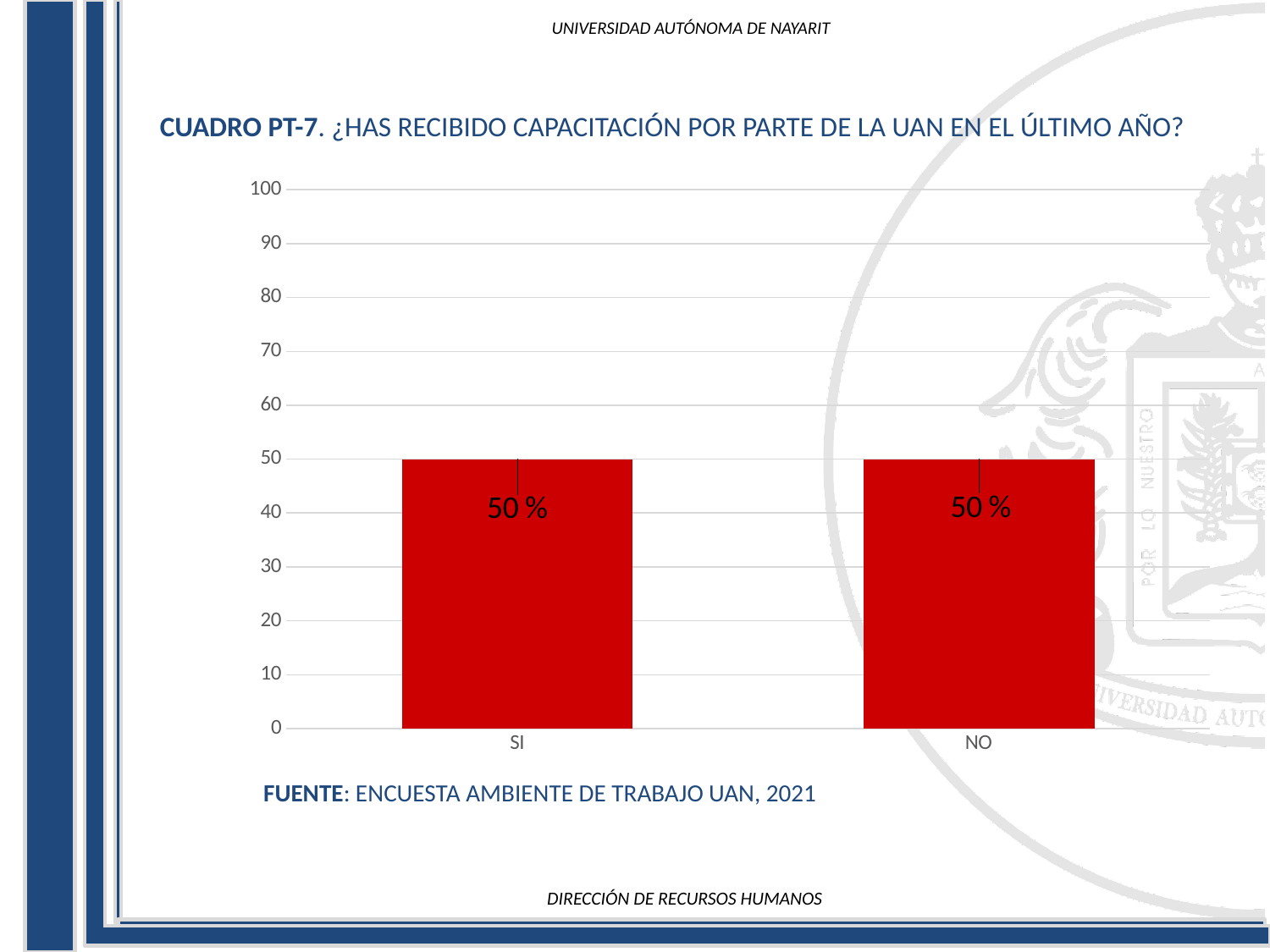
What is the total of the values for SI and NO? 100 % What kind of chart is shown on the slide? bar chart Is the value for SI greater or less than 60? less What colour are the bars in the chart? red What is the value for NO? 50 % Is the value for NO greater or less than 40? greater What is the value for SI? 50 % How many categories are shown on the x axis? 2 What is the maximum value shown on the y axis? 100 What is the difference between the values for SI and NO? 0 %